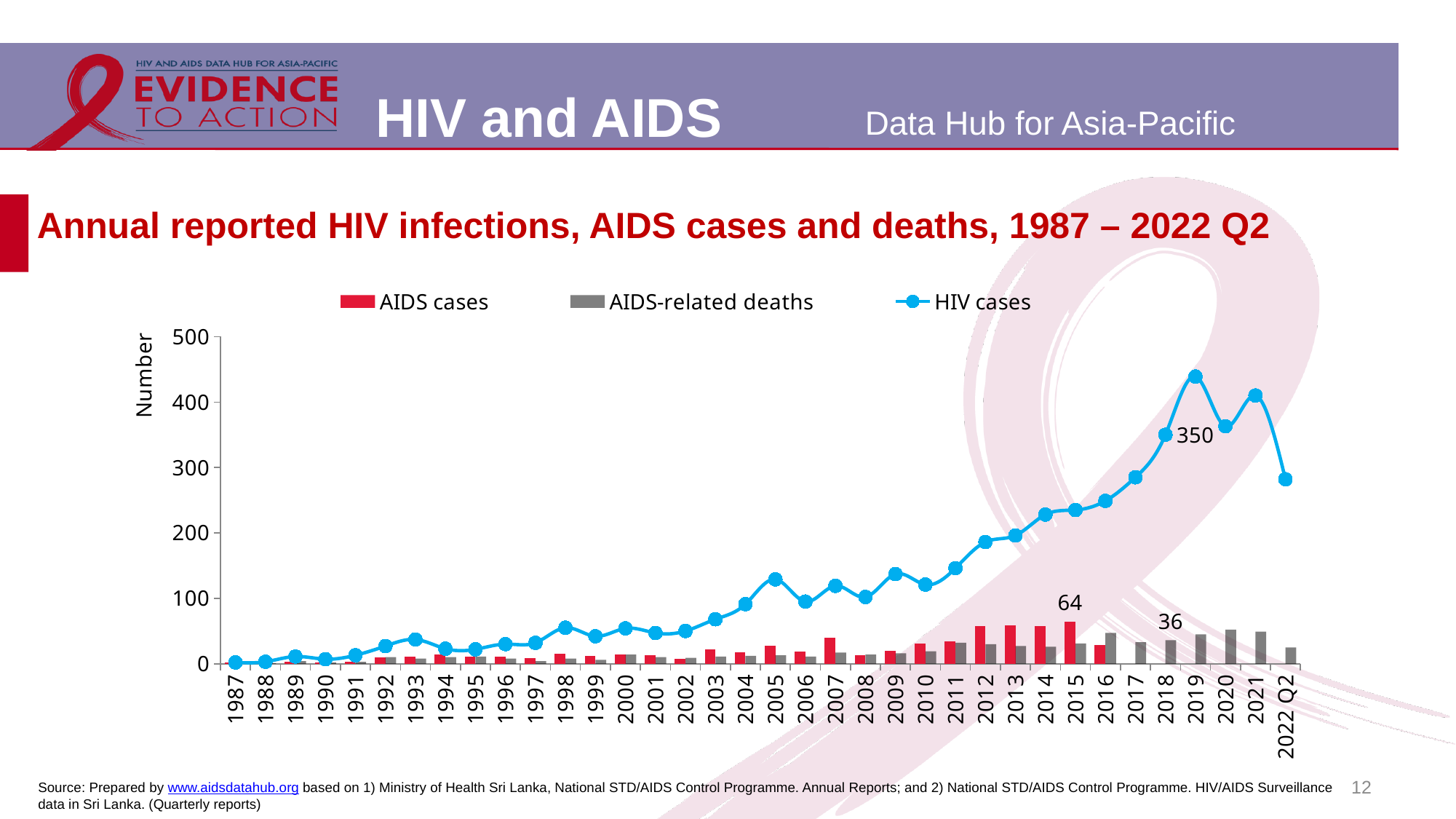
How many series does the legend list? 3 Is the value for HIV cases in 2022 Q2 greater or less than 300? less What is the number of HIV cases reported in 2018? 350 What is the label on the vertical axis? Number What kind of chart is shown on the slide? Combined bar and line chart What is the number of AIDS cases reported in 2015? 64 Which year has more HIV cases, 2019 or 2021? 2019 In which year do HIV cases reach their highest value? 2019 Do HIV cases rise or fall from 2016 to 2019? rise What is the number of AIDS-related deaths reported in 2018? 36 How many time periods are shown on the x axis? 36 Is the value for HIV cases in 2019 greater or less than 400? greater